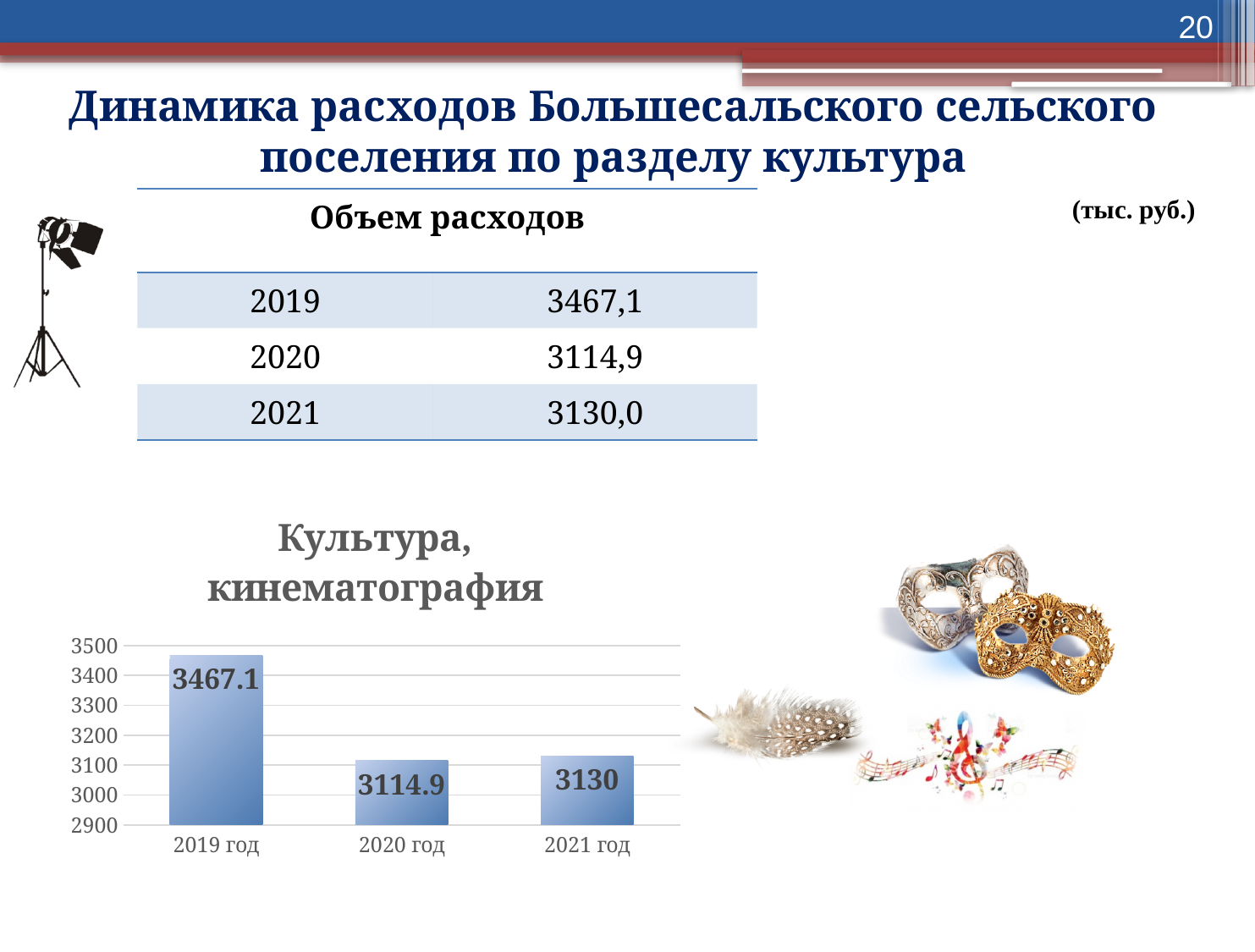
What kind of chart is shown on the slide? bar chart Which is larger, the value for 2020 год or 2021 год? 2021 год What is the value for 2021 год in the chart? 3130 What is the difference between the values for 2021 год and 2020 год? 15.1 What is the title of the chart? Культура, кинематография What is the value for 2019 год in the chart? 3467.1 Which year has the highest value in the chart? 2019 год Is the value for 2019 год greater or less than 3400? greater How many bars are in the chart? 3 What is the value for 2020 год in the chart? 3114.9 What is the difference between the values for 2019 год and 2020 год? 352.2 Which year has the lowest value in the chart? 2020 год